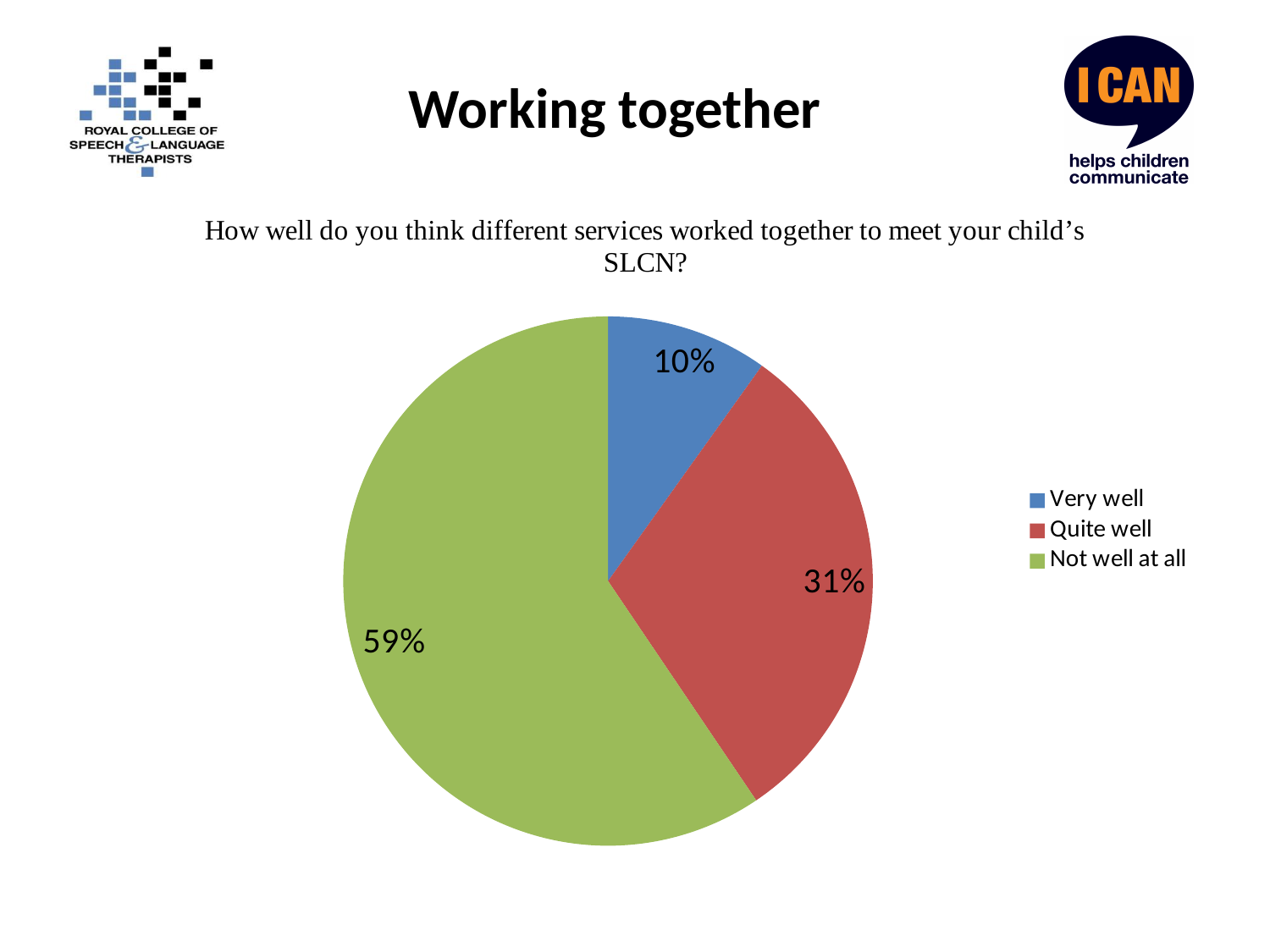
What percentage of respondents said services worked together 'Very well'? 10% What is the difference in percentage points between 'Not well at all' and 'Quite well'? 28 What is the difference in percentage points between 'Quite well' and 'Very well'? 21 Which response category has the smallest share of the pie? Very well What question is the pie chart answering, according to the text above it? How well do you think different services worked together to meet your child's SLCN? What percentage of respondents said services worked together 'Not well at all'? 59% Which response category has the largest share of the pie? Not well at all How many categories does the legend list? 3 Which is larger, the share for 'Quite well' or the share for 'Very well'? Quite well What colour is the 'Not well at all' slice? Green What kind of chart is shown on the slide? Pie chart What percentage of respondents said services worked together 'Quite well'? 31%